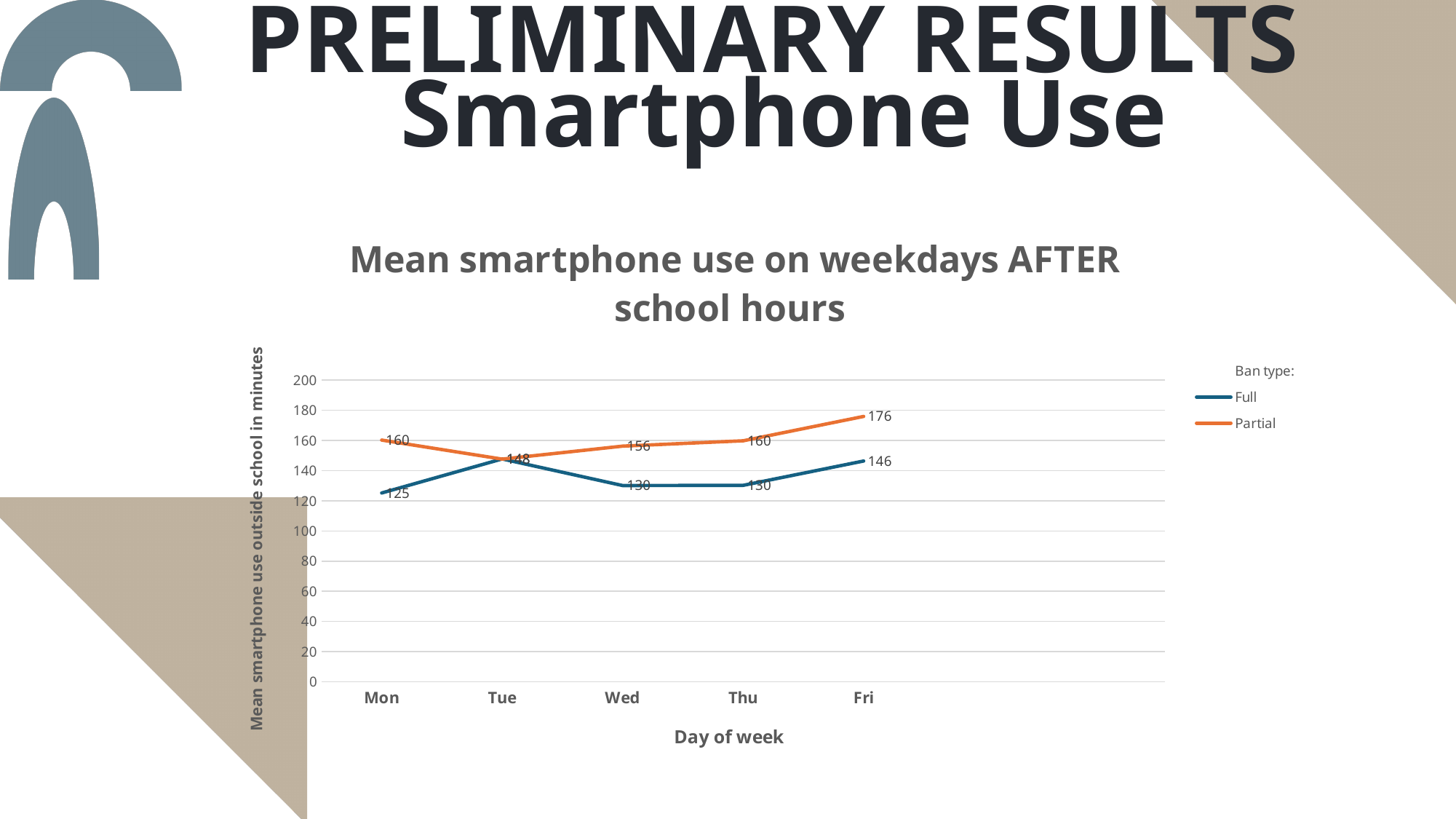
What is the title of the y axis? Mean smartphone use outside school in minutes On which day is the Partial ban type value highest? Fri How many days of the week are plotted on the x axis? 5 What is the value for the Partial ban type on Wed? 156 What is the difference between the Partial and Full values on Fri? 30 What kind of chart is shown on the slide? line chart What is the value for the Full ban type on Mon? 125 What is the value for the Partial ban type on Fri? 176 How many series does the legend list? 2 On which day is the Full ban type value lowest? Mon What is the value for the Full ban type on Thu? 130 On Thu, which ban type has the larger value, Full or Partial? Partial